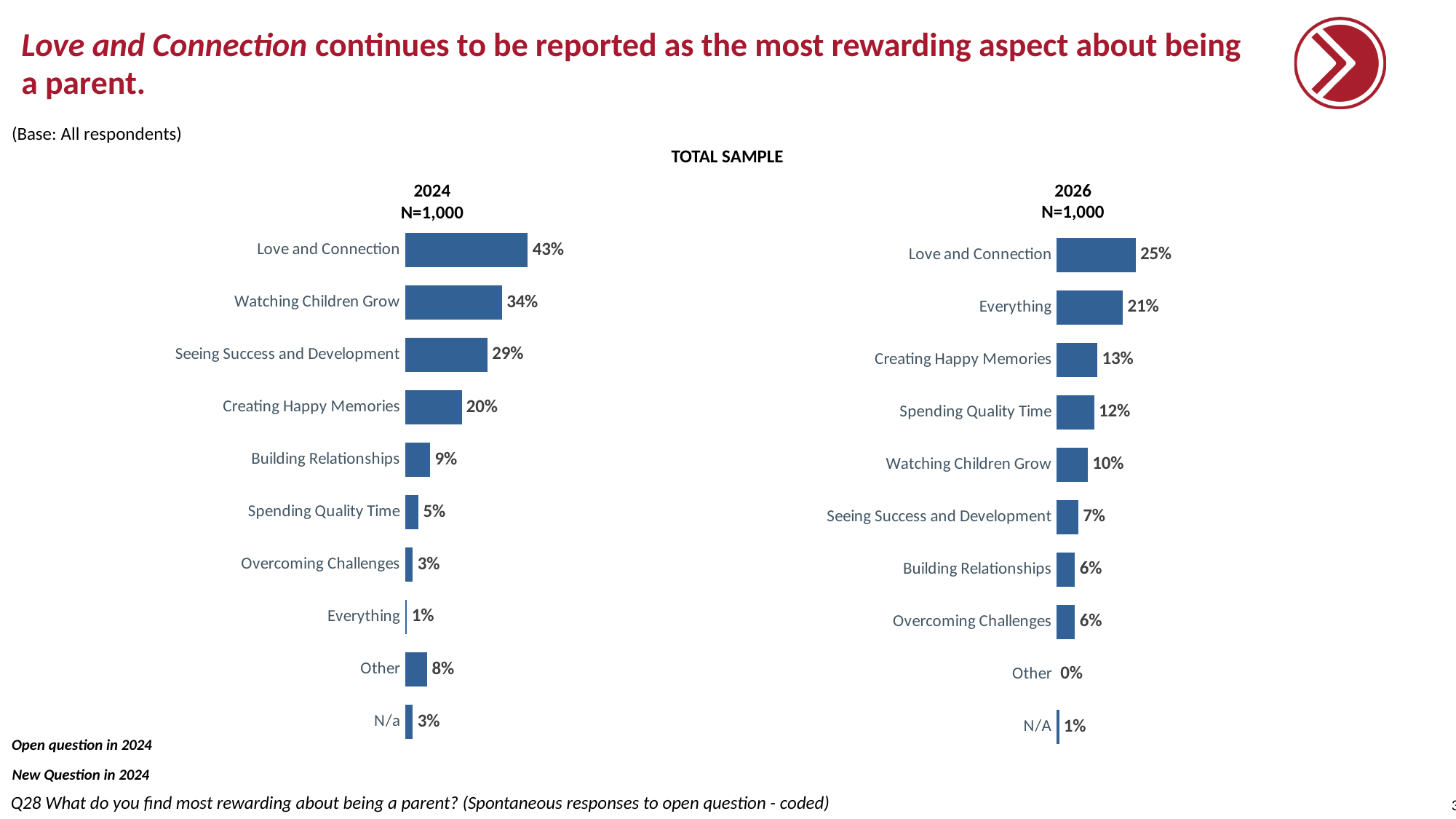
In the 2026 chart, which category has the highest value? Love and Connection How many categories are shown in the 2026 chart? 10 What is the difference between Love and Connection in the 2024 chart and Love and Connection in the 2026 chart? 18 percentage points In the 2024 chart, what percentage is shown for Love and Connection? 43% In the 2024 chart, what percentage is shown for Spending Quality Time? 5% What is the sample size (N) shown for the 2024 chart? N=1,000 In the 2024 chart, what is the difference between Watching Children Grow and Seeing Success and Development? 5 percentage points In the 2026 chart, which category has the lowest value? Other In the 2026 chart, what percentage is shown for Everything? 21% What type of chart is used on this slide? Bar chart In the 2024 chart, which category has the lowest value? Everything Which is larger: Creating Happy Memories in the 2024 chart or Creating Happy Memories in the 2026 chart? 2024 chart